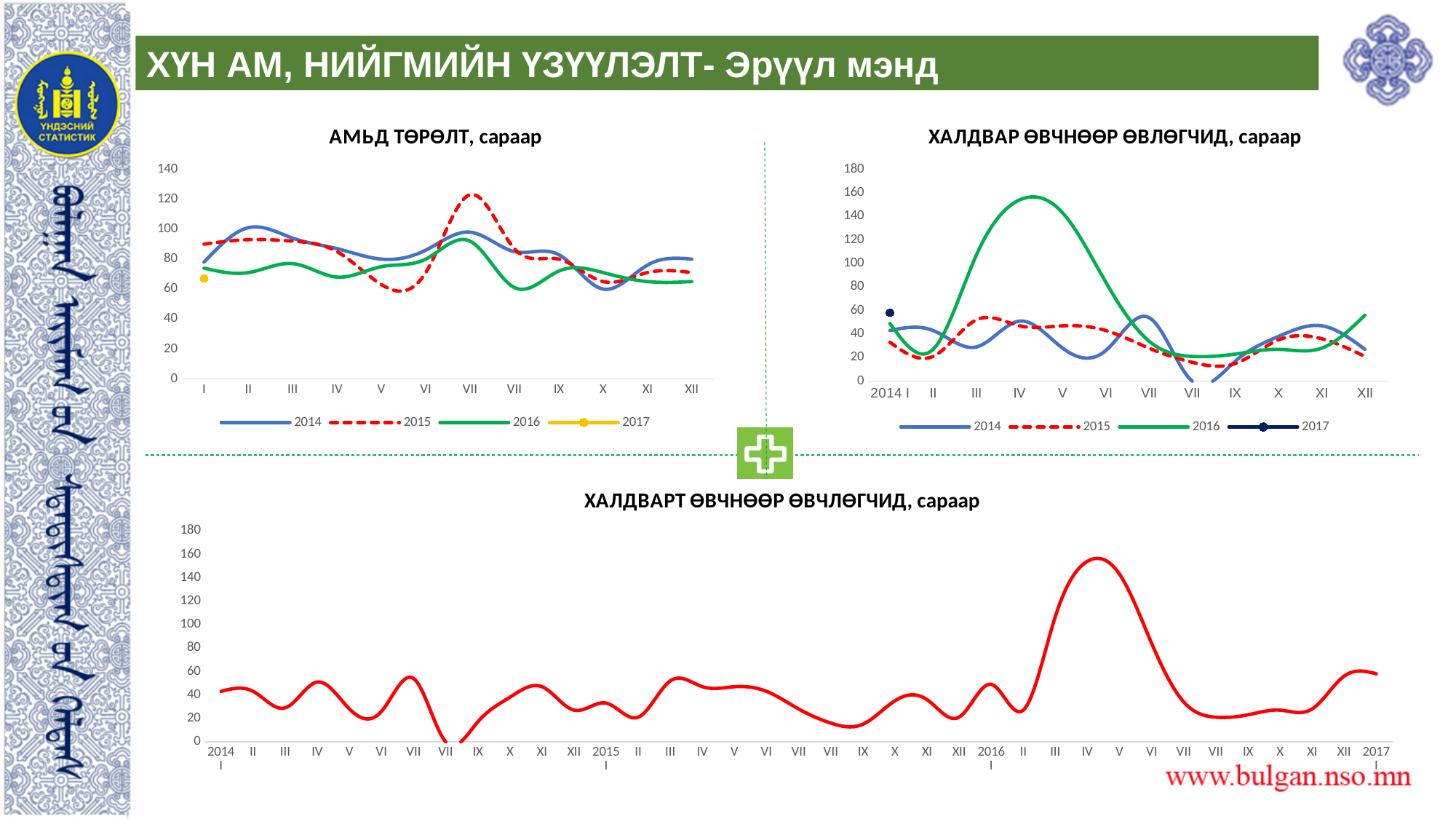
In the "АМЬД ТӨРӨЛТ, сараар" chart, is the 2017 value at I greater or less than 80? less In the "АМЬД ТӨРӨЛТ, сараар" chart, is the 2015 value at VII greater or less than 100? greater How many months are shown on the x axis of the "АМЬД ТӨРӨЛТ, сараар" chart? 12 In the "ХАЛДВАР ӨВЧНӨӨР ӨВЛӨГЧИД, сараар" chart, is the 2017 value at I greater or less than 80? less What kind of chart is the "АМЬД ТӨРӨЛТ, сараар" chart at the top left? line chart What is the highest value shown on the y axis of the "ХАЛДВАР ӨВЧНӨӨР ӨВЛӨГЧИД, сараар" chart? 180 In the "ХАЛДВАР ӨВЧНӨӨР ӨВЛӨГЧИД, сараар" chart at the top right, which series reaches the highest value? 2016 What colour is the line in the bottom chart "ХАЛДВАРТ ӨВЧНӨӨР ӨВЧЛӨГЧИД, сараар"? red How many series does the legend of the "АМЬД ТӨРӨЛТ, сараар" chart list? 4 In the "АМЬД ТӨРӨЛТ, сараар" chart, which series reaches the highest peak? 2015